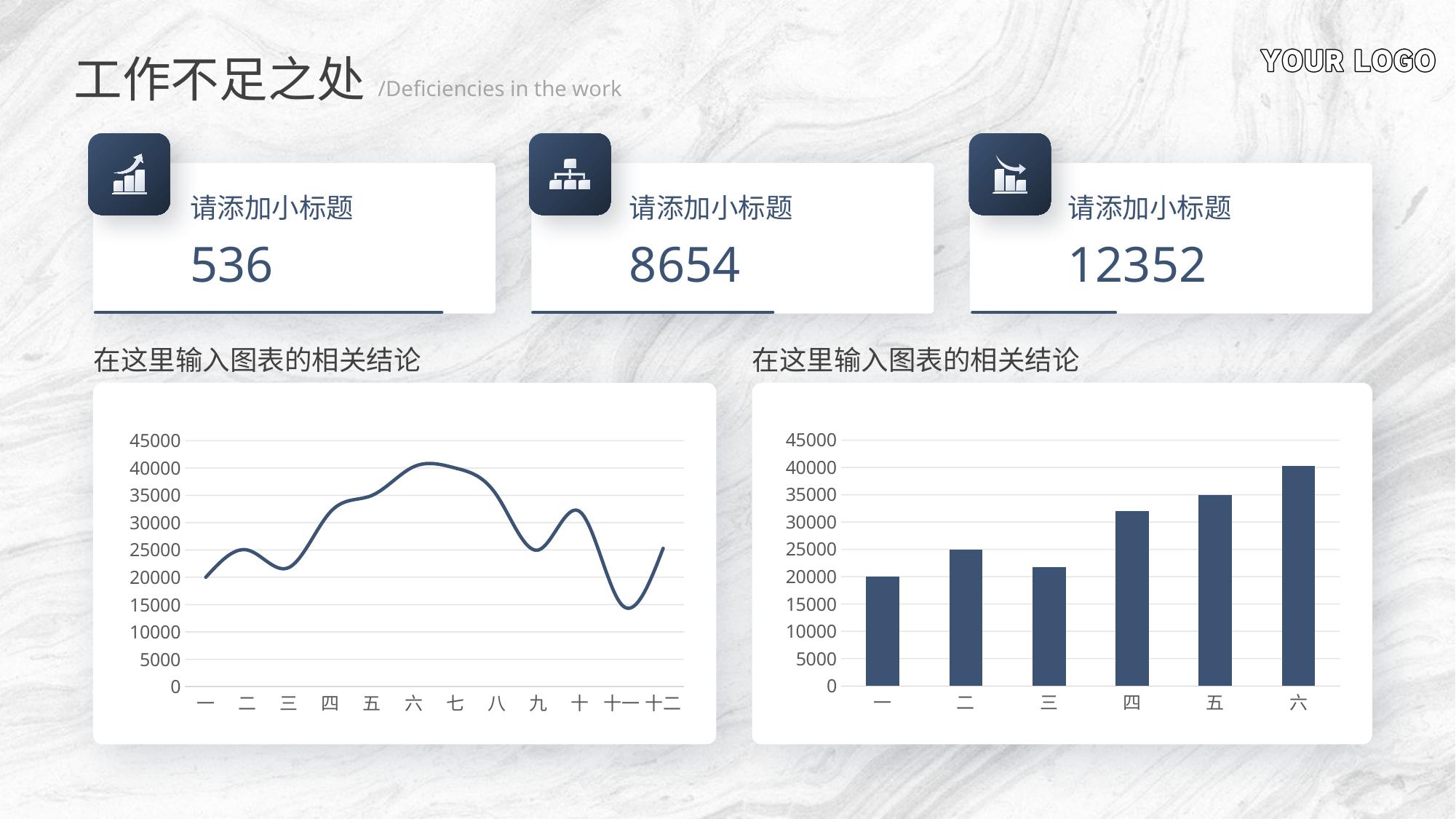
In the bar chart on the right, is the value for 四 greater or less than 30000? greater What kind of chart is the chart on the right of the slide? bar chart In the bar chart on the right, what is the value for 一? 20000 What kind of chart is the chart on the left of the slide? line chart In the line chart on the left, which category has the lowest value? 十一 In the line chart on the left, is the value for 六 greater or less than 35000? greater How many bars are in the bar chart on the right? 6 In the line chart on the left, is the value for 十一 greater or less than 20000? less In the bar chart on the right, which category has the shortest bar? 一 In the bar chart on the right, which category has the tallest bar? 六 How many categories are shown on the x axis of the line chart on the left? 12 In the line chart on the left, which category has the highest value? 六